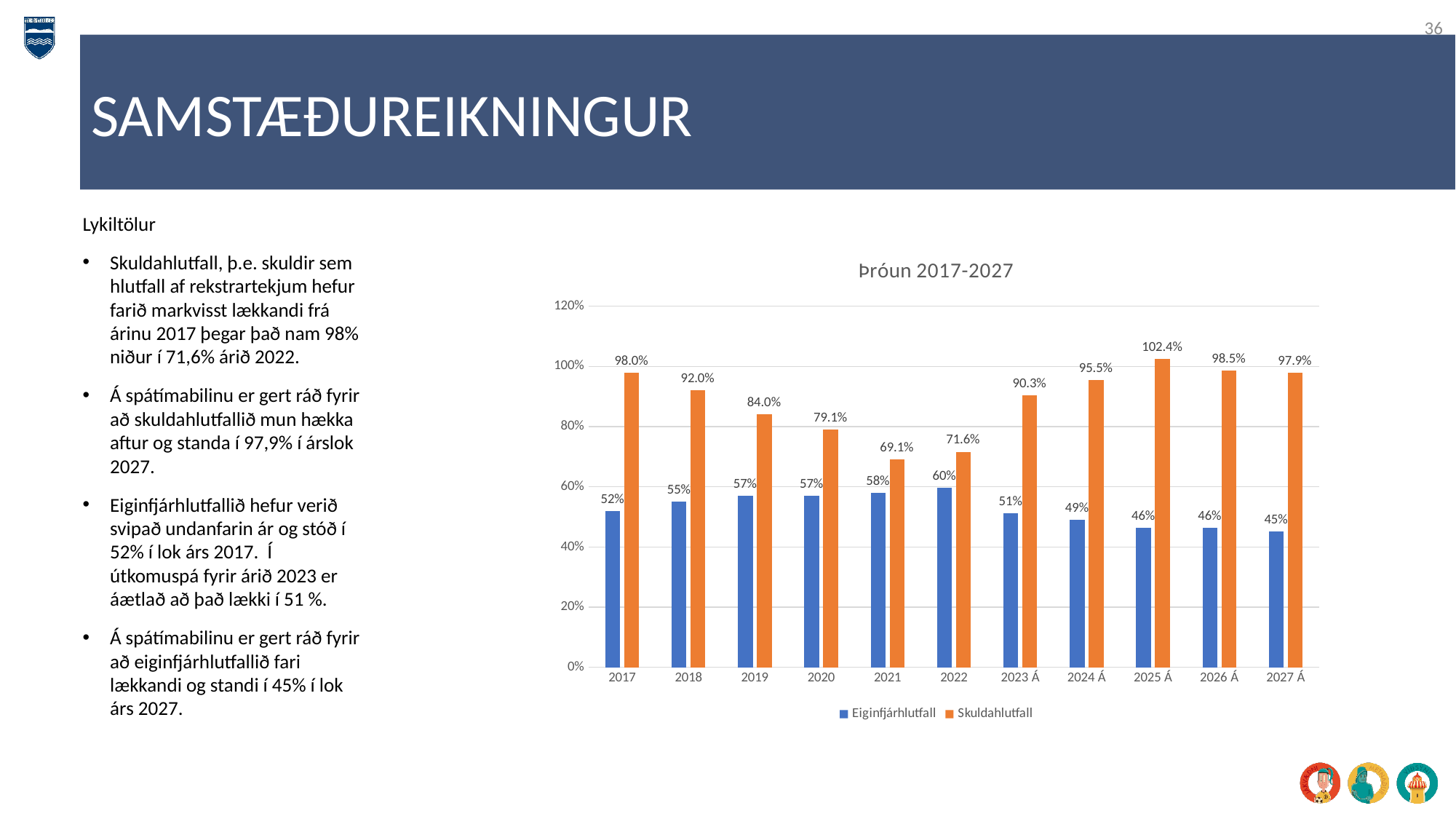
In which year is Eiginfjárhlutfall highest? 2022 What is the Skuldahlutfall value for 2027 Á? 97.9% How many years are shown on the x axis? 11 Which is larger, the Eiginfjárhlutfall value for 2018 or for 2024 Á? 2018 What is the title of the chart? Þróun 2017-2027 What is the Skuldahlutfall value for 2017? 98.0% In which year is Skuldahlutfall lowest? 2021 How many series does the legend list? 2 What is the Eiginfjárhlutfall value for 2022? 60% In which year is Skuldahlutfall highest? 2025 Á What is the difference between the Skuldahlutfall values for 2025 Á and 2022? 30.8% What kind of chart is shown? Bar chart